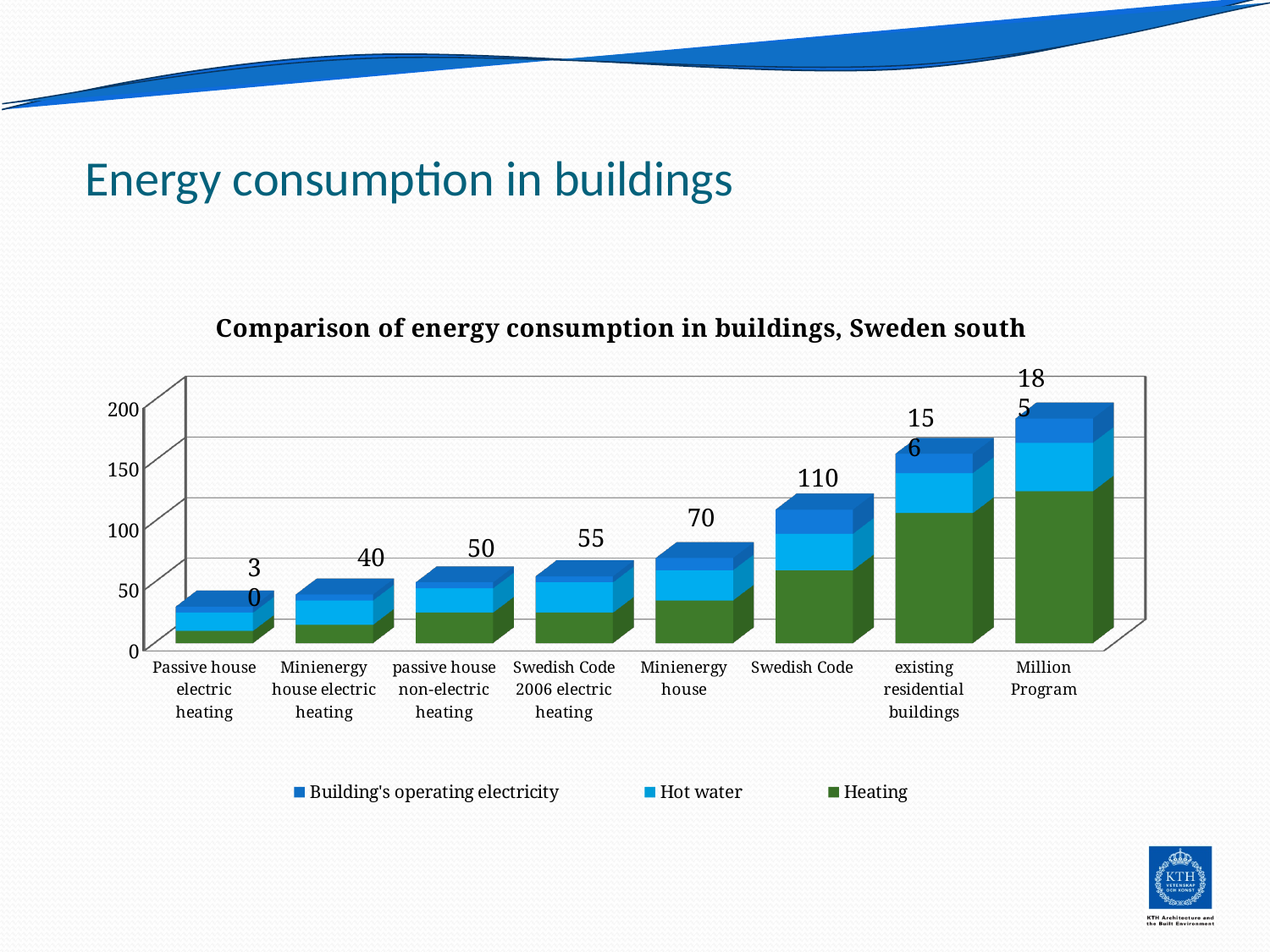
Is the total stacked bar for Passive house electric heating greater or less than 50? less Which series is shown in green in the chart? Heating What is the title of the chart? Comparison of energy consumption in buildings, Sweden south Is the total stacked bar for Million Program greater or less than 150? greater How many series does the chart's legend list? 3 Is the total stacked bar for existing residential buildings greater or less than 100? greater Which has the taller stacked bar, Swedish Code or Minienergy house? Swedish Code What kind of chart is shown on the slide? Stacked bar chart How many categories are shown along the x axis of the chart? 8 Which category has the tallest stacked bar in the chart? Million Program Do the stacked bar totals generally rise or fall from left to right along the x axis? rise Which category has the shortest stacked bar in the chart? Passive house electric heating